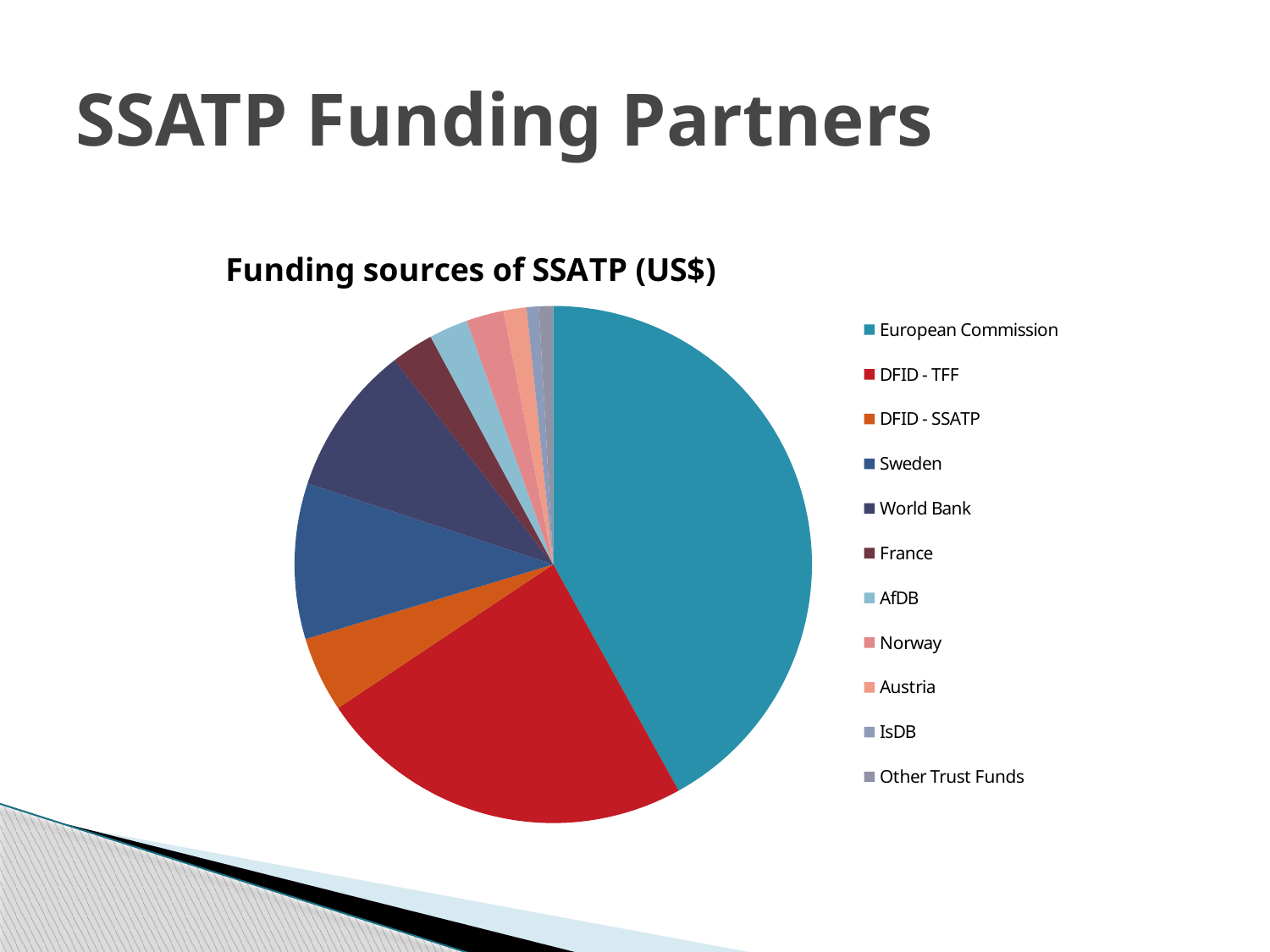
What kind of chart is shown on the slide? pie chart Which is larger, the slice for World Bank or the slice for AfDB? World Bank Which funding source is the second-largest slice of the pie? DFID - TFF Which is larger, the slice for DFID - TFF or the slice for DFID - SSATP? DFID - TFF What is the title of the chart? Funding sources of SSATP (US$) How many funding sources are listed in the chart's legend? 11 Which is larger, the slice for Sweden or the slice for France? Sweden Which funding source has the largest slice of the pie? European Commission Which funding source is listed last in the legend? Other Trust Funds